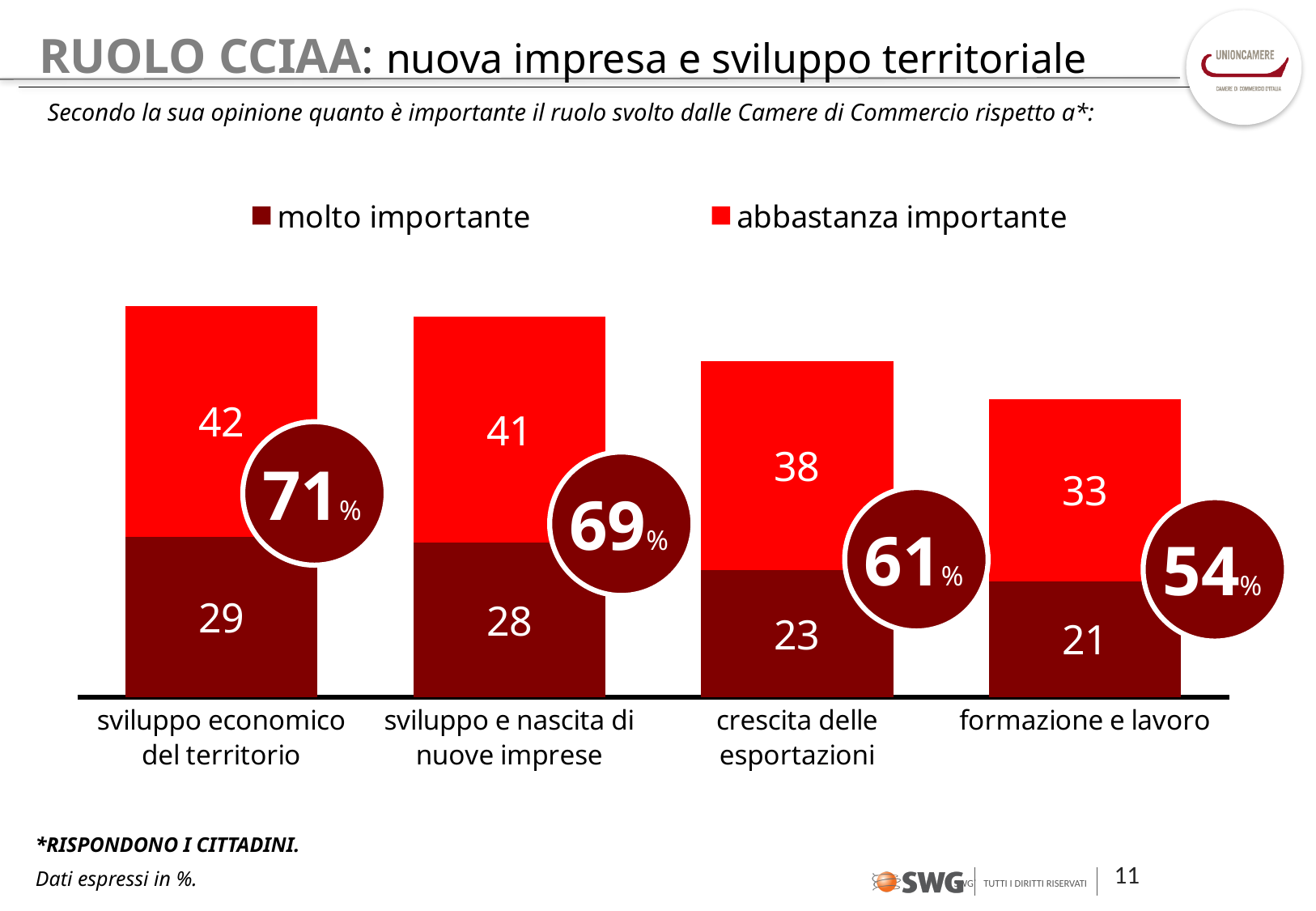
Which category has the lowest value for "molto importante"? formazione e lavoro Which is larger: the "molto importante" value for "sviluppo e nascita di nuove imprese" or for "crescita delle esportazioni"? sviluppo e nascita di nuove imprese Which category has the highest total? sviluppo economico del territorio What kind of chart is shown on the slide? stacked bar chart What is the value for "molto importante" for "sviluppo economico del territorio"? 29 How many categories are shown on the x axis? 4 What is the total of the stacked bar for "formazione e lavoro"? 54% What is the value for "molto importante" for "formazione e lavoro"? 21 What is the value for "abbastanza importante" for "crescita delle esportazioni"? 38 What is the total shown in the circle for "sviluppo e nascita di nuove imprese"? 69% What is the difference between the "abbastanza importante" values for "sviluppo economico del territorio" and "formazione e lavoro"? 9 How many series does the legend list? 2